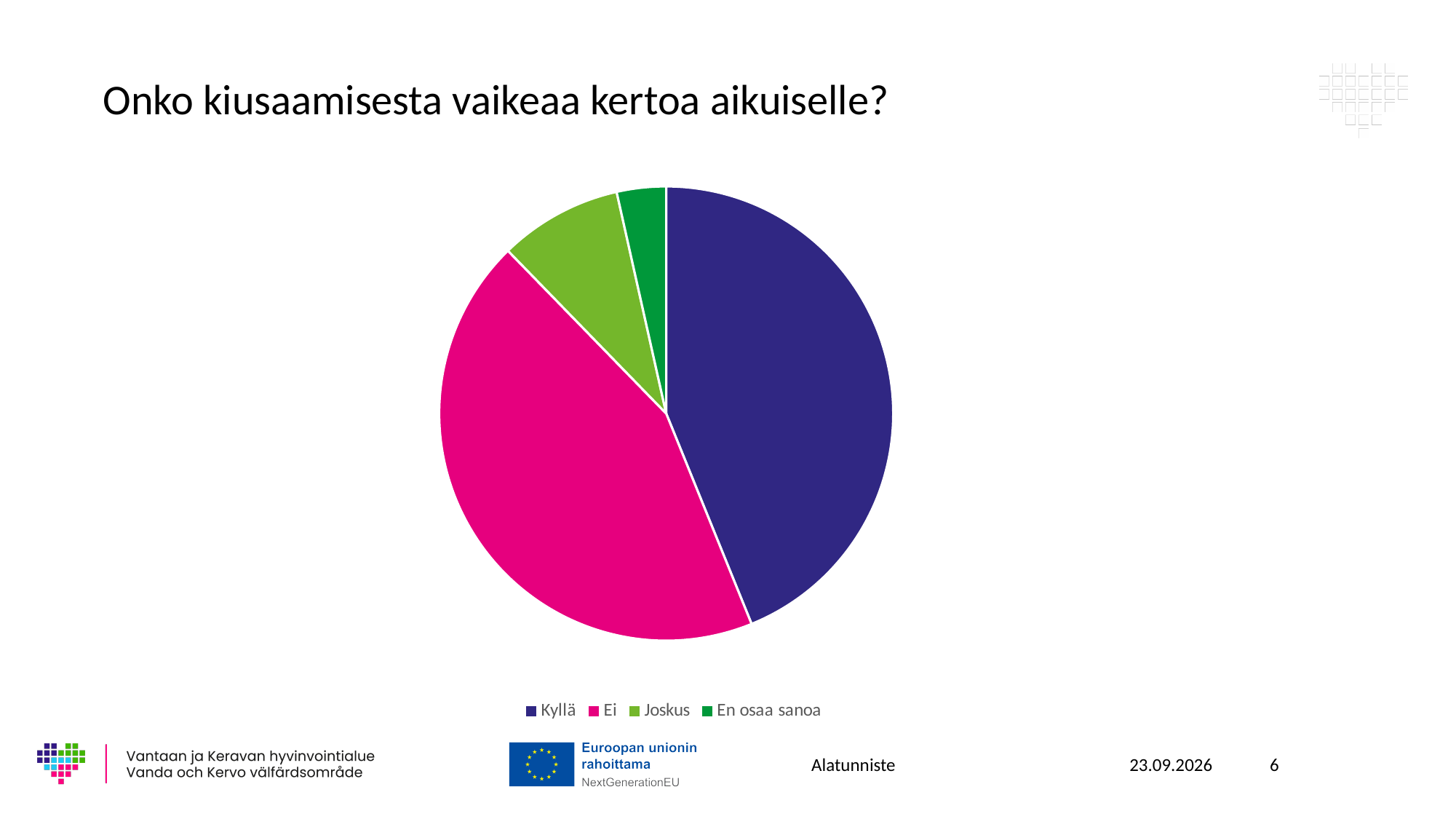
Which category is shown in pink in the pie chart? Ei Which slice is larger, Joskus or En osaa sanoa? Joskus Which slice is larger, Kyllä or Joskus? Kyllä Which category has the smallest slice in the pie chart? En osaa sanoa Which slice is larger, Ei or En osaa sanoa? Ei How many entries does the legend of the pie chart list? 4 What is the title of the slide containing the pie chart? Onko kiusaamisesta vaikeaa kertoa aikuiselle? What kind of chart is shown on the slide? pie chart How many categories does the pie chart have? 4